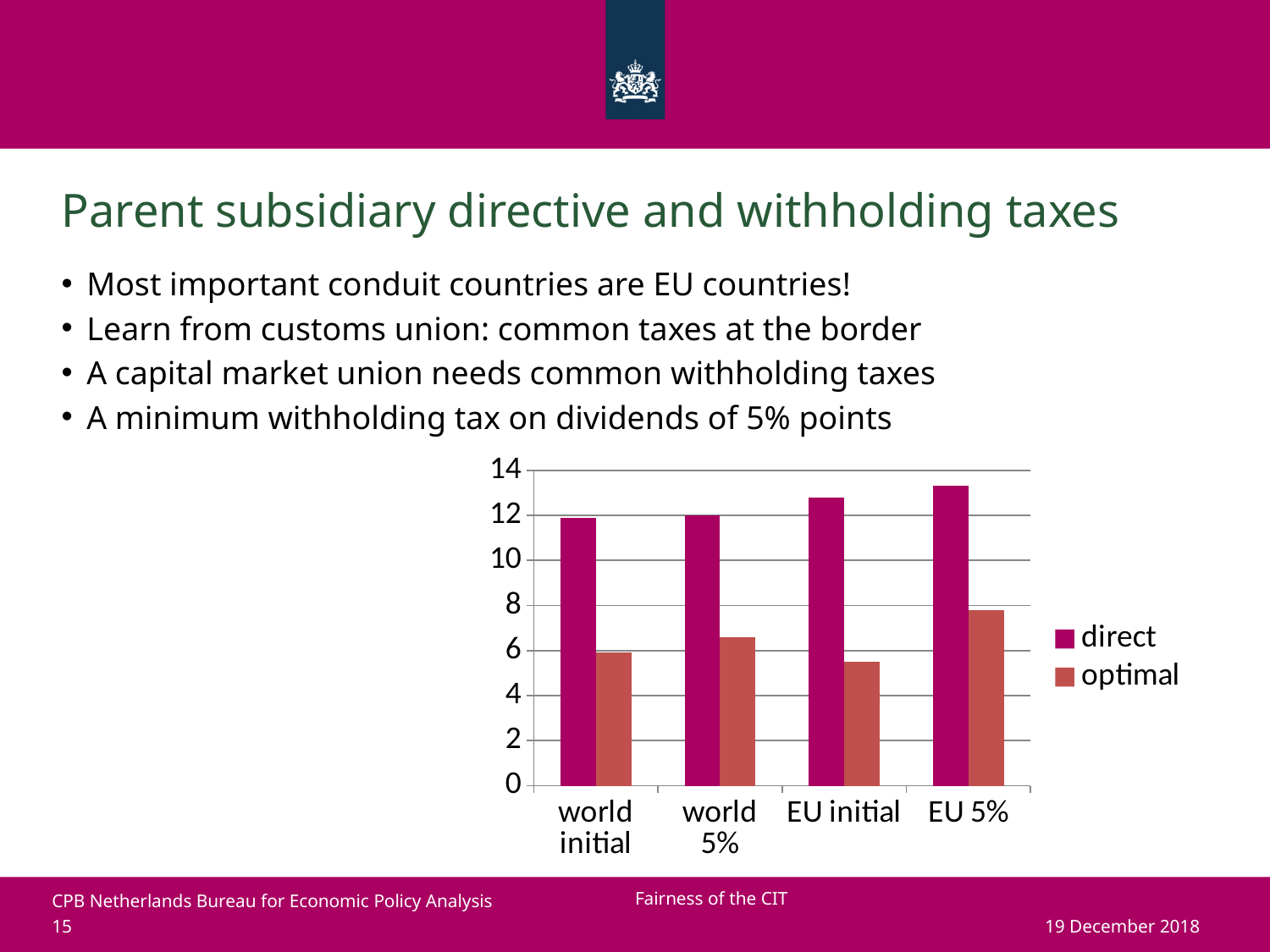
Is the optimal value for EU initial greater or less than 6? less Do the values of the direct series rise or fall from world initial to EU 5%? rise Which two series are listed in the chart's legend? direct and optimal How many series does the chart's legend list? 2 What kind of chart is shown on the slide? bar chart Which category has the highest value for the direct series? EU 5% How many categories are shown on the x axis of the chart? 4 For the world 5% category, which series has the larger value, direct or optimal? direct Is the direct value for EU initial greater or less than 12? greater Is the direct value for EU 5% greater or less than 12? greater Which category has the highest value for the optimal series? EU 5%